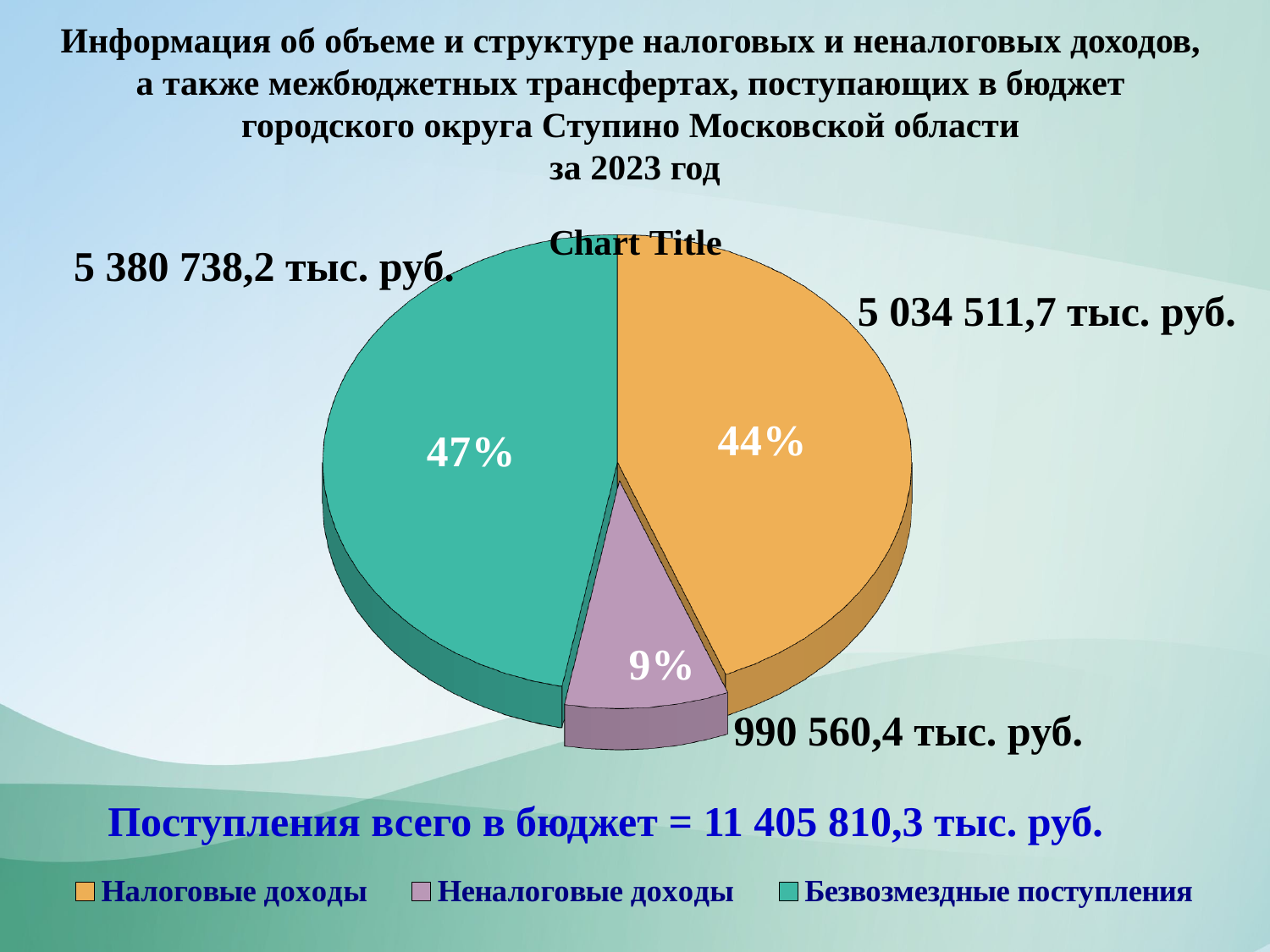
What share of the pie does Неналоговые доходы represent? 9% What share of the pie does Безвозмездные поступления represent? 47% What is the value shown for Неналоговые доходы? 990 560,4 тыс. руб. Which category has the largest share of the pie? Безвозмездные поступления By how many percentage points does the share of Безвозмездные поступления exceed the share of Налоговые доходы? 3 percentage points Which category has the smallest share of the pie? Неналоговые доходы What share of the pie does Налоговые доходы represent? 44% What colour is the slice for Налоговые доходы? orange How many entries does the legend list? 3 What is the value shown for Безвозмездные поступления? 5 380 738,2 тыс. руб. What kind of chart is shown on the slide? pie chart How many slices does the pie chart have? 3